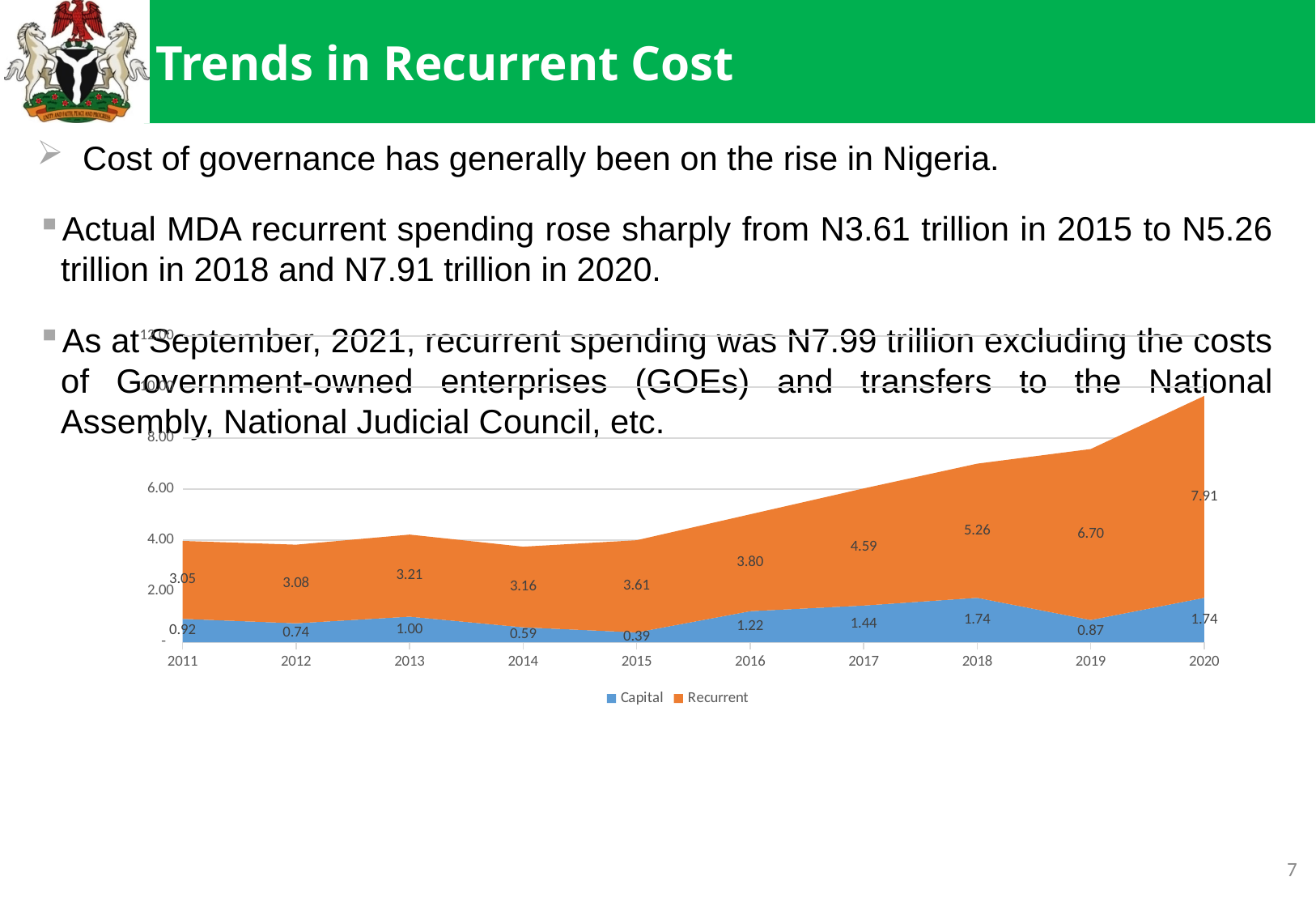
What kind of chart is shown on the slide? Stacked area chart Which is larger, the Capital value for 2016 or the Capital value for 2019? 2016 How many years are shown on the x axis of the chart? 10 In which year is the Recurrent value highest? 2020 How many series does the chart legend list? 2 In which year is the Capital value lowest? 2015 What is the Capital value for 2015? 0.39 What is the difference between the Recurrent values for 2020 and 2019? 1.21 What is the combined total of Capital and Recurrent for 2020? 9.65 What are the two series named in the chart legend? Capital and Recurrent What is the Recurrent value for 2018? 5.26 Does the Recurrent series generally rise or fall from 2011 to 2020? Rise